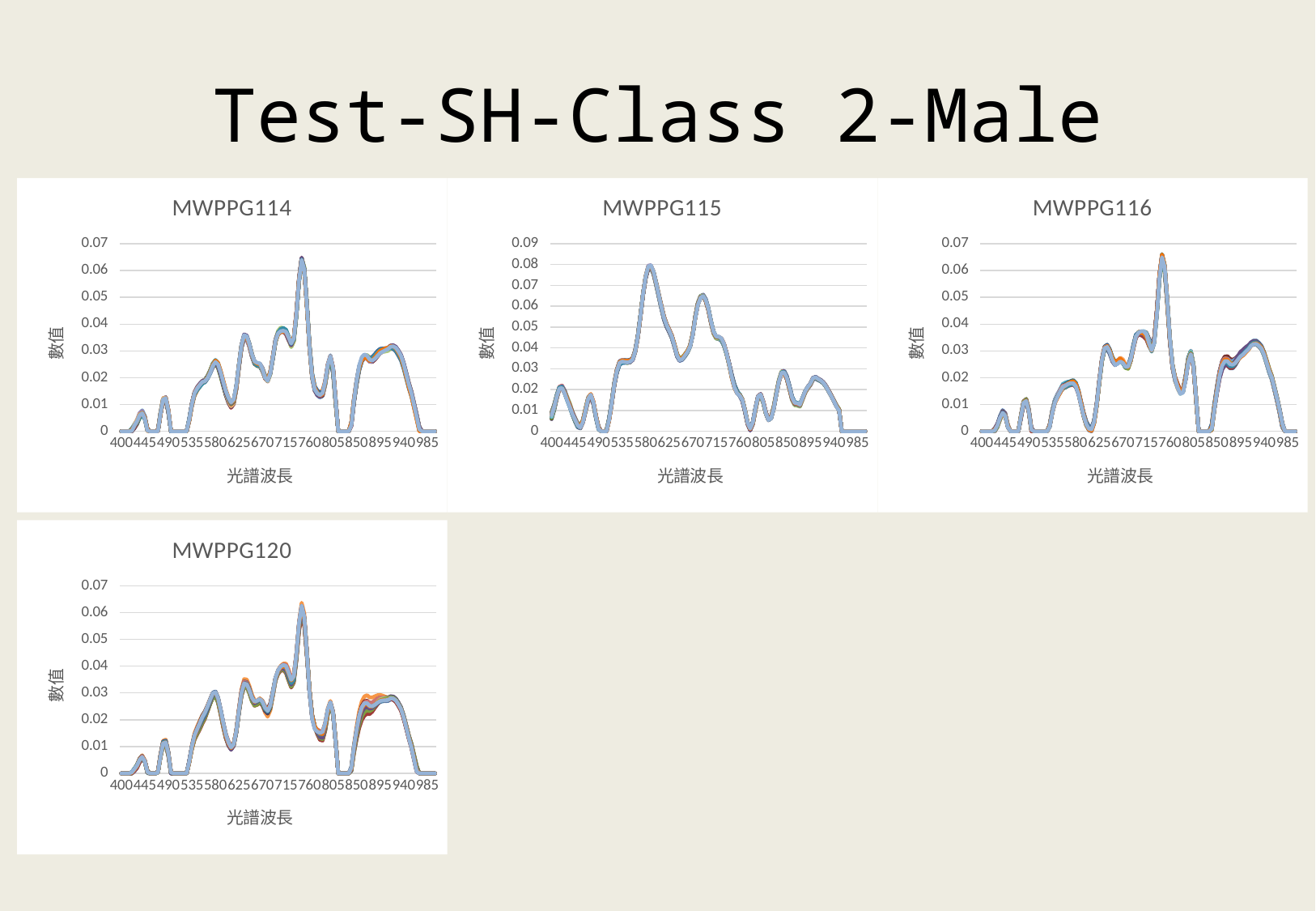
What is the highest y-axis tick label on the MWPPG115 chart? 0.09 Which chart has the highest peak value: MWPPG115 or MWPPG120? MWPPG115 In the MWPPG120 chart, is the highest value plotted greater or less than 0.05? greater How many charts are shown on the slide? 4 In the MWPPG115 chart, is the value at 400 greater or less than 0.03? less In the MWPPG114 chart, is the value at 985 greater or less than 0.02? less How many tick labels are shown on the x axis of the MWPPG120 chart? 14 What kind of chart is MWPPG114? line chart What is the x-axis title of the MWPPG116 chart? 光譜波長